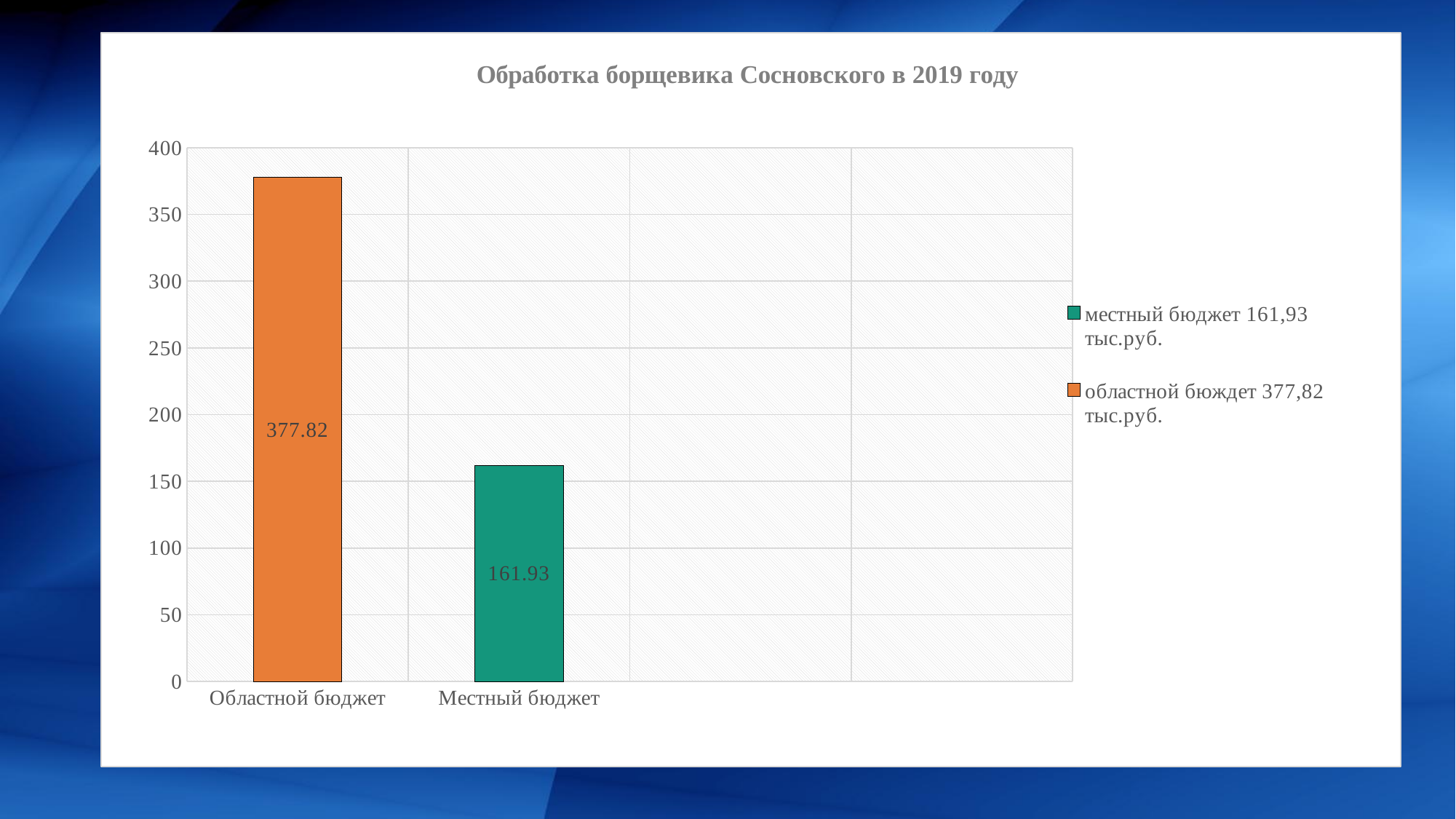
What is the value for Местный бюджет? 161.93 What kind of chart is shown on the slide? bar chart How many entries does the legend list? 2 Is the value for Местный бюджет greater or less than 200? less Which category has the lowest value? Местный бюджет What is the title of the chart? Обработка борщевика Сосновского в 2019 году Which is larger, the value for Областной бюджет or the value for Местный бюджет? Областной бюджет What is the value for Областной бюджет? 377.82 Which category has the highest value? Областной бюджет Is the value for Областной бюджет greater or less than 350? greater What is the difference between the values for Областной бюджет and Местный бюджет? 215.89 How many categories are shown on the x axis? 2